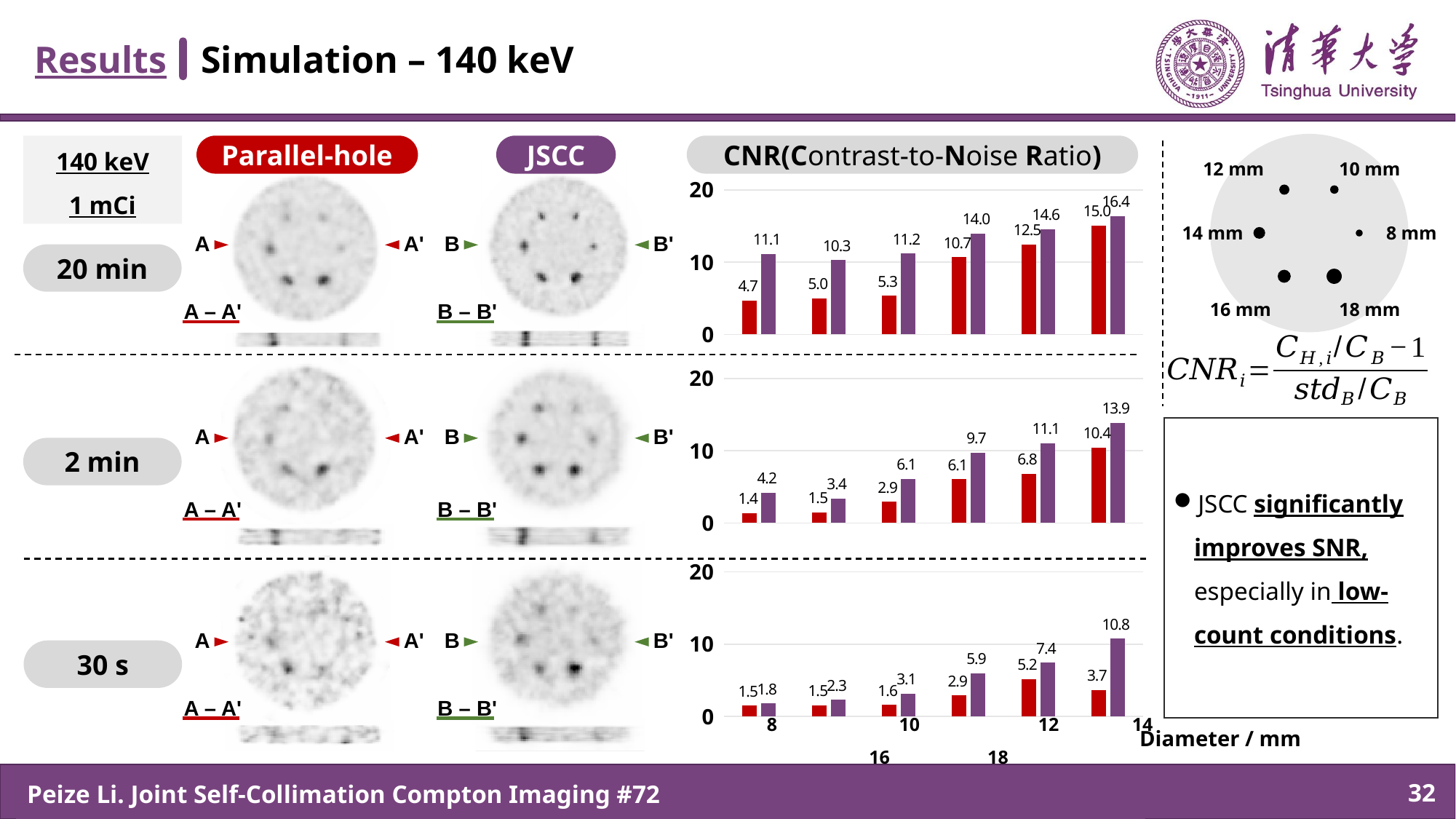
In the 20 min CNR chart, is the Parallel-hole value in the leftmost group greater or less than 10? less In the 30 s CNR chart, what is the JSCC (purple) value in the rightmost group of bars? 10.8 What is the title shown above the CNR charts? CNR(Contrast-to-Noise Ratio) In the 2 min CNR chart, what is the difference between the JSCC and Parallel-hole values in the rightmost group of bars? 3.5 In the 20 min CNR chart, which is larger in the leftmost group of bars: the Parallel-hole value or the JSCC value? JSCC In the 30 s CNR chart, what is the Parallel-hole (red) value in the leftmost group of bars? 1.5 What type of chart is used to show the CNR results on this slide? Bar chart In the 2 min CNR chart, do the JSCC (purple) values rise or fall from left to right? Rise In the 20 min CNR chart, what is the lowest Parallel-hole (red) value shown? 4.7 In the 20 min CNR chart, what is the highest JSCC (purple) value shown? 16.4 How many groups of bars are there in the 20 min CNR chart? 6 In the 30 s CNR chart, what is the difference between the JSCC and Parallel-hole values in the fourth group of bars from the left? 3.0